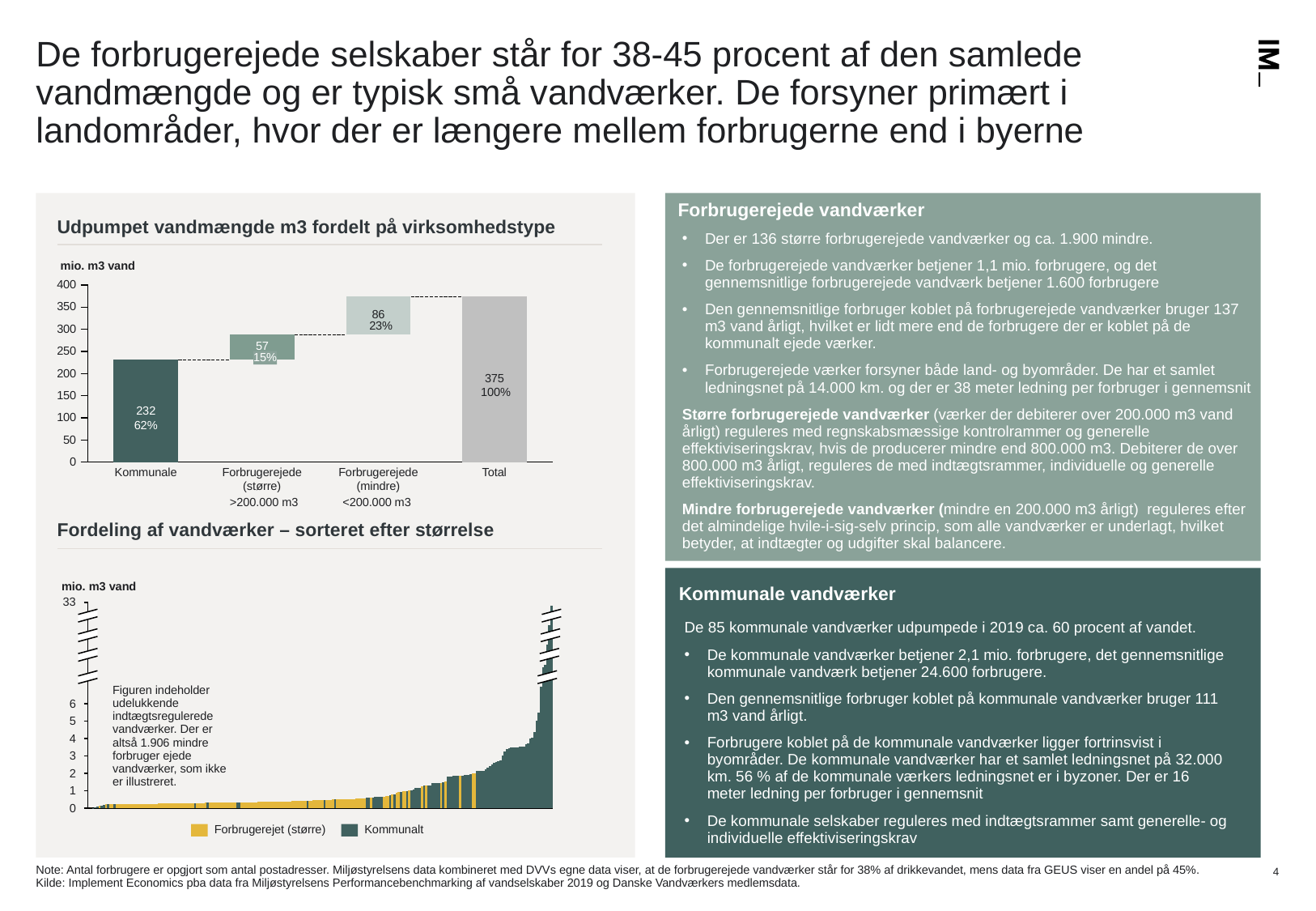
How many series does the legend of the chart 'Fordeling af vandværker – sorteret efter størrelse' list? 2 What unit is shown on the y axis of the chart 'Fordeling af vandværker – sorteret efter størrelse'? mio. m3 vand In the chart 'Udpumpet vandmængde m3 fordelt på virksomhedstype', what is the Total value? 375 In the chart 'Udpumpet vandmængde m3 fordelt på virksomhedstype', what is the value for Forbrugerejede (større)? 57 In the chart 'Udpumpet vandmængde m3 fordelt på virksomhedstype', what percentage share is shown for Forbrugerejede (mindre)? 23% In the chart 'Udpumpet vandmængde m3 fordelt på virksomhedstype', what is the difference between the Kommunale value and the Forbrugerejede (mindre) value? 146 In the chart 'Udpumpet vandmængde m3 fordelt på virksomhedstype', which is larger: Forbrugerejede (større) or Forbrugerejede (mindre)? Forbrugerejede (mindre) In the chart 'Udpumpet vandmængde m3 fordelt på virksomhedstype', what is the value for Kommunale? 232 In the chart 'Udpumpet vandmængde m3 fordelt på virksomhedstype', which category (excluding Total) has the highest value? Kommunale In the chart 'Udpumpet vandmængde m3 fordelt på virksomhedstype', what is the value for Forbrugerejede (mindre)? 86 In the chart 'Udpumpet vandmængde m3 fordelt på virksomhedstype', what percentage share is shown for Kommunale? 62% In the chart 'Udpumpet vandmængde m3 fordelt på virksomhedstype', which category (excluding Total) has the lowest value? Forbrugerejede (større)